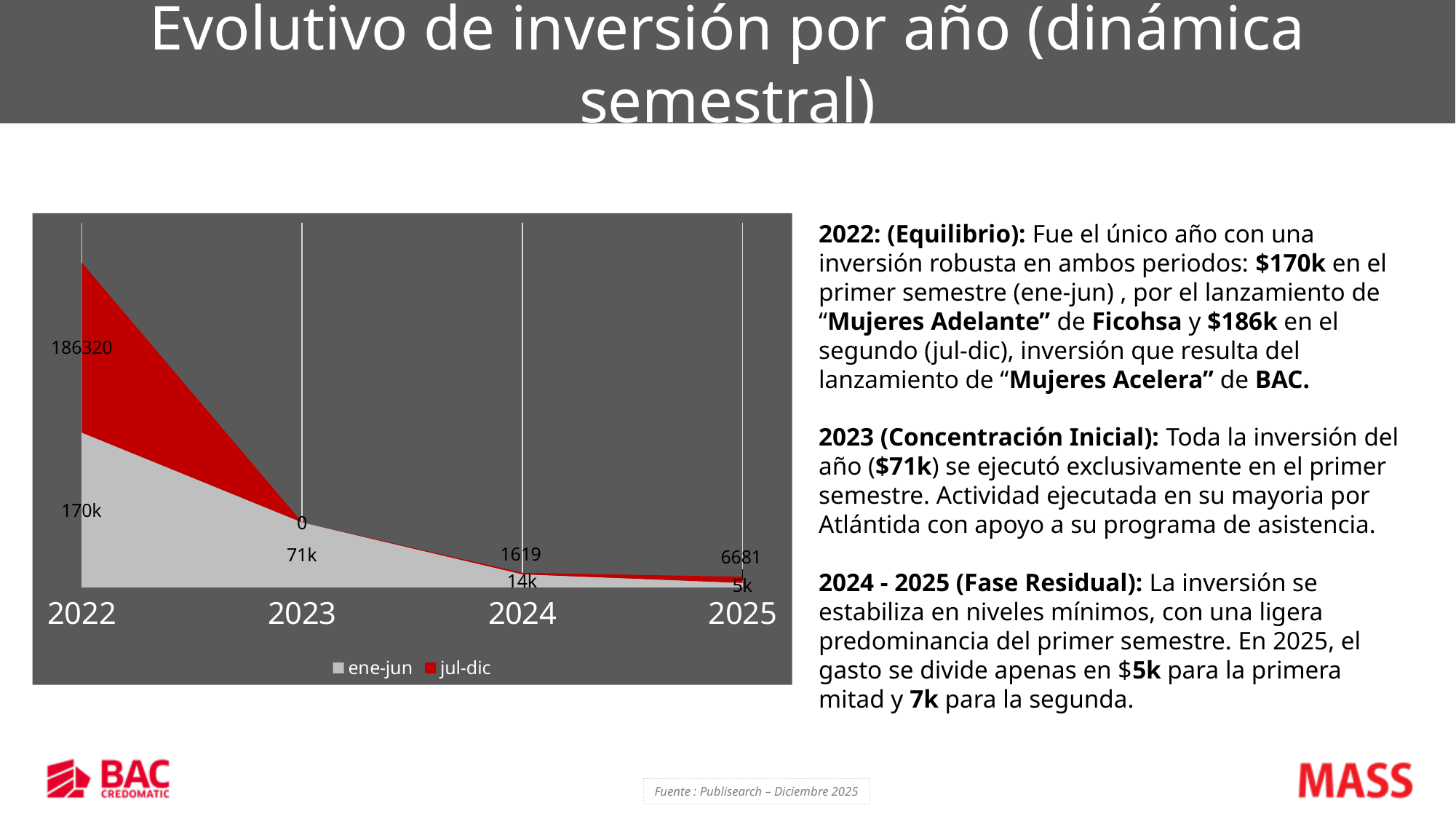
What is the jul-dic value for 2023? 0 In 2025, which is larger: the ene-jun value or the jul-dic value? jul-dic What is the difference between the ene-jun values for 2022 and 2023? 99k What is the ene-jun value for 2023? 71k Which year has the highest ene-jun value? 2022 What is the jul-dic value for 2024? 1619 Which year has the lowest ene-jun value? 2025 What kind of chart is shown? area chart How many years are shown on the x axis? 4 What is the jul-dic value for 2022? 186320 Does the ene-jun value rise or fall from 2022 to 2025? fall How many series does the legend list? 2